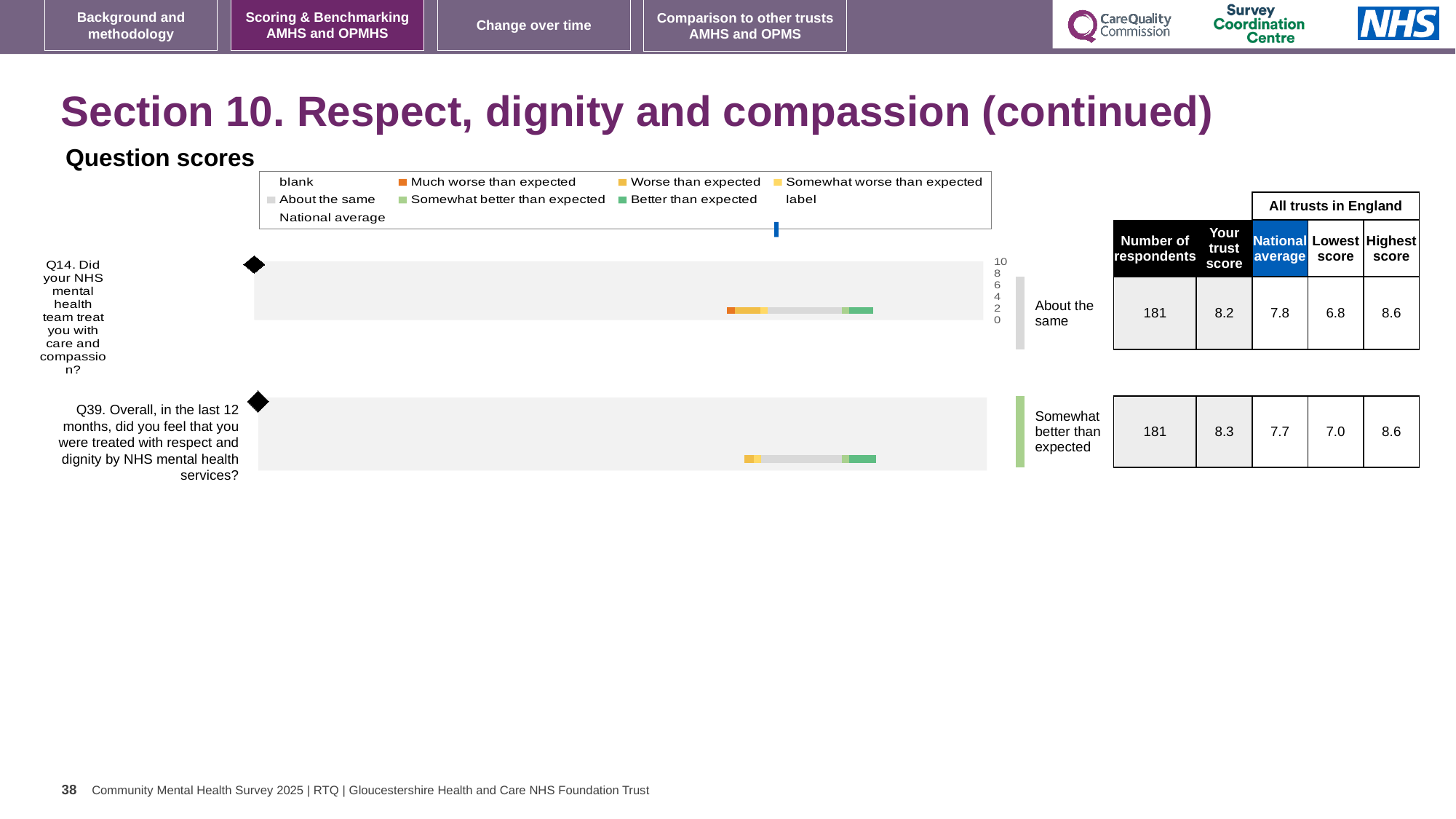
Which benchmark category is Q39 placed in? Somewhat better than expected What is the highest score among all trusts in England for Q39? 8.6 What is the difference between the trust score and the national average for Q39? 0.6 What is the difference between the highest and lowest scores for Q14? 1.8 What is the national average score for Q39 (respect and dignity)? 7.7 What is the trust score for Q14 (care and compassion)? 8.2 Which benchmark category is Q14 placed in? About the same How many questions are plotted on the chart? 2 Which question has the higher trust score, Q14 or Q39? Q39 What kind of chart is shown on the slide? Bar chart What is the lowest score among all trusts in England for Q14? 6.8 How many respondents answered Q39? 181